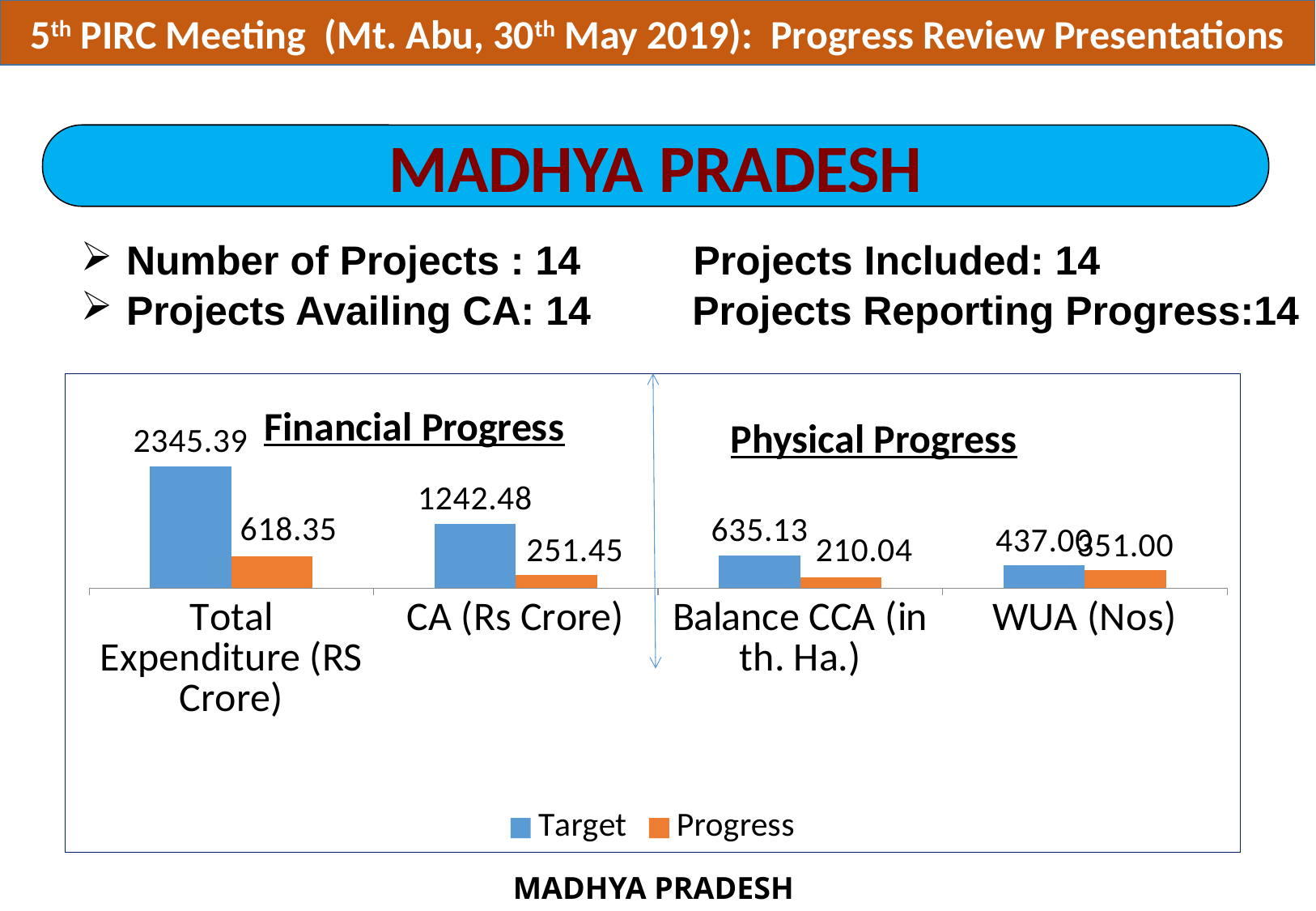
What is the Progress value for Total Expenditure (RS Crore)? 618.35 How many series does the chart legend list? 2 What type of chart is shown on the slide? Bar chart What is the difference between the Target and Progress values for Total Expenditure (RS Crore)? 1727.04 What is the Target value for Total Expenditure (RS Crore)? 2345.39 What is the Progress value for Balance CCA (in th. Ha.)? 210.04 Which category has the highest Target value? Total Expenditure (RS Crore) What is the difference between the Target and Progress values for CA (Rs Crore)? 991.03 Which is larger for Balance CCA (in th. Ha.): the Target value or the Progress value? Target How many categories are shown on the x axis of the chart? 4 Which series is shown in orange in the chart? Progress What is the Target value for CA (Rs Crore)? 1242.48